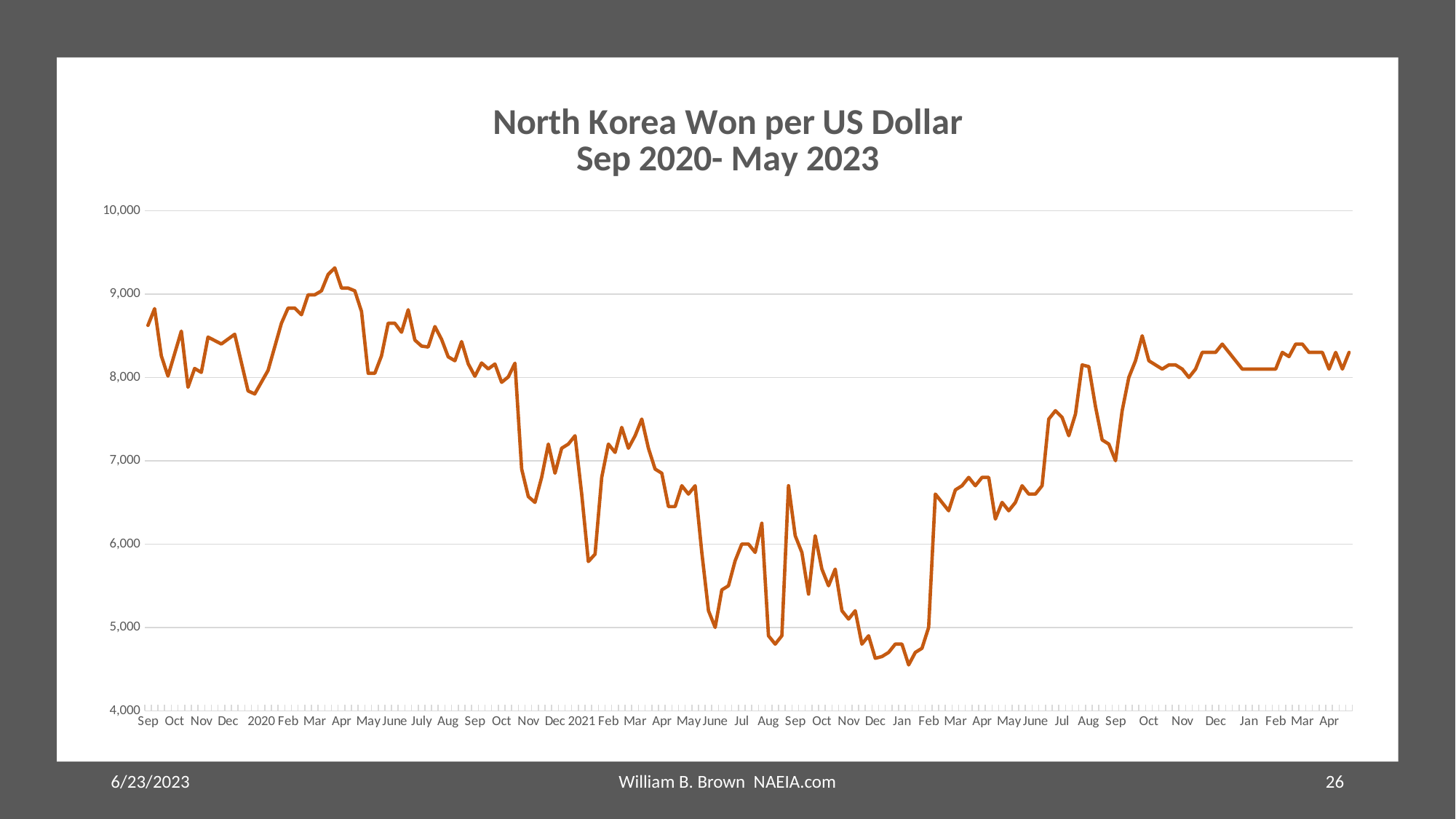
Do the values generally rise or fall from the first Apr peak to the Jan low? fall Is the peak value near the first Apr label greater or less than 9,000? greater What kind of chart is shown on the slide? line chart Which is larger: the value at the first Apr label or the value at the last Apr label? the first Apr label Around which x-axis label does the line reach its highest point? Apr (the first Apr label) Is the value at the first Sep label greater or less than 8,000? greater Is the value at the Nov label that follows the 2021 section's Oct (the dip around 6,500) greater or less than 7,000? less Around which x-axis label does the line reach its lowest point? Jan (the Jan label between Dec and Feb) What is the title of the chart? North Korea Won per US Dollar Sep 2020- May 2023 What is the highest value shown on the vertical axis? 10,000